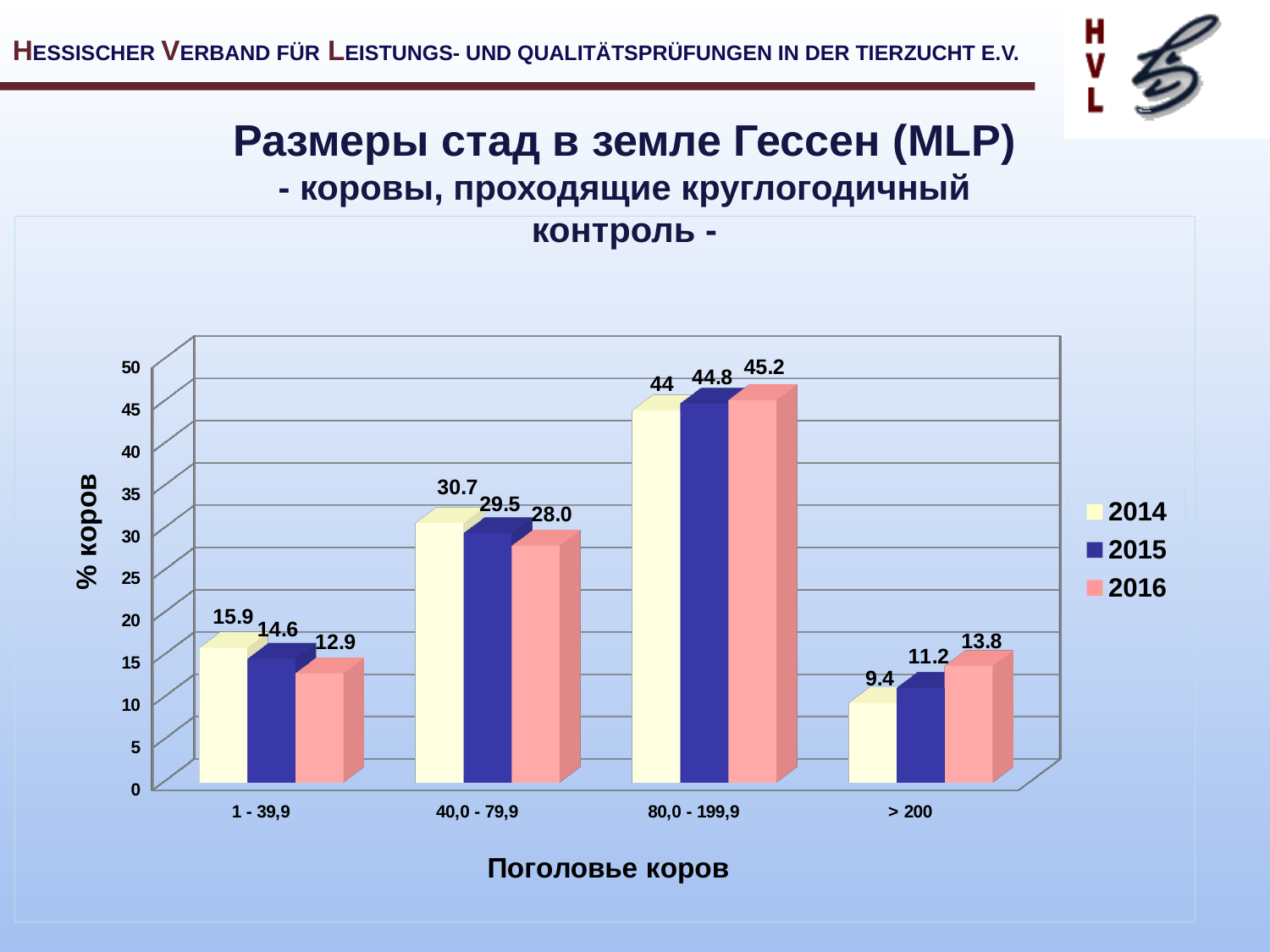
What is the value for 2016 in the 80,0 - 199,9 category? 45.2 Do the values for 2016 rise or fall from the 1 - 39,9 category to the 80,0 - 199,9 category? rise What is the label of the y axis? % коров What is the value for 2015 in the > 200 category? 11.2 How many categories are shown on the x axis? 4 Which category has the lowest value for 2014? > 200 What is the difference between the 2014 and 2016 values in the 40,0 - 79,9 category? 2.7 What is the value for 2014 in the 1 - 39,9 category? 15.9 What kind of chart is shown on the slide? bar chart How many series does the legend list? 3 Which category has the highest value for 2015? 80,0 - 199,9 Which is larger in the > 200 category: the 2014 value or the 2016 value? 2016